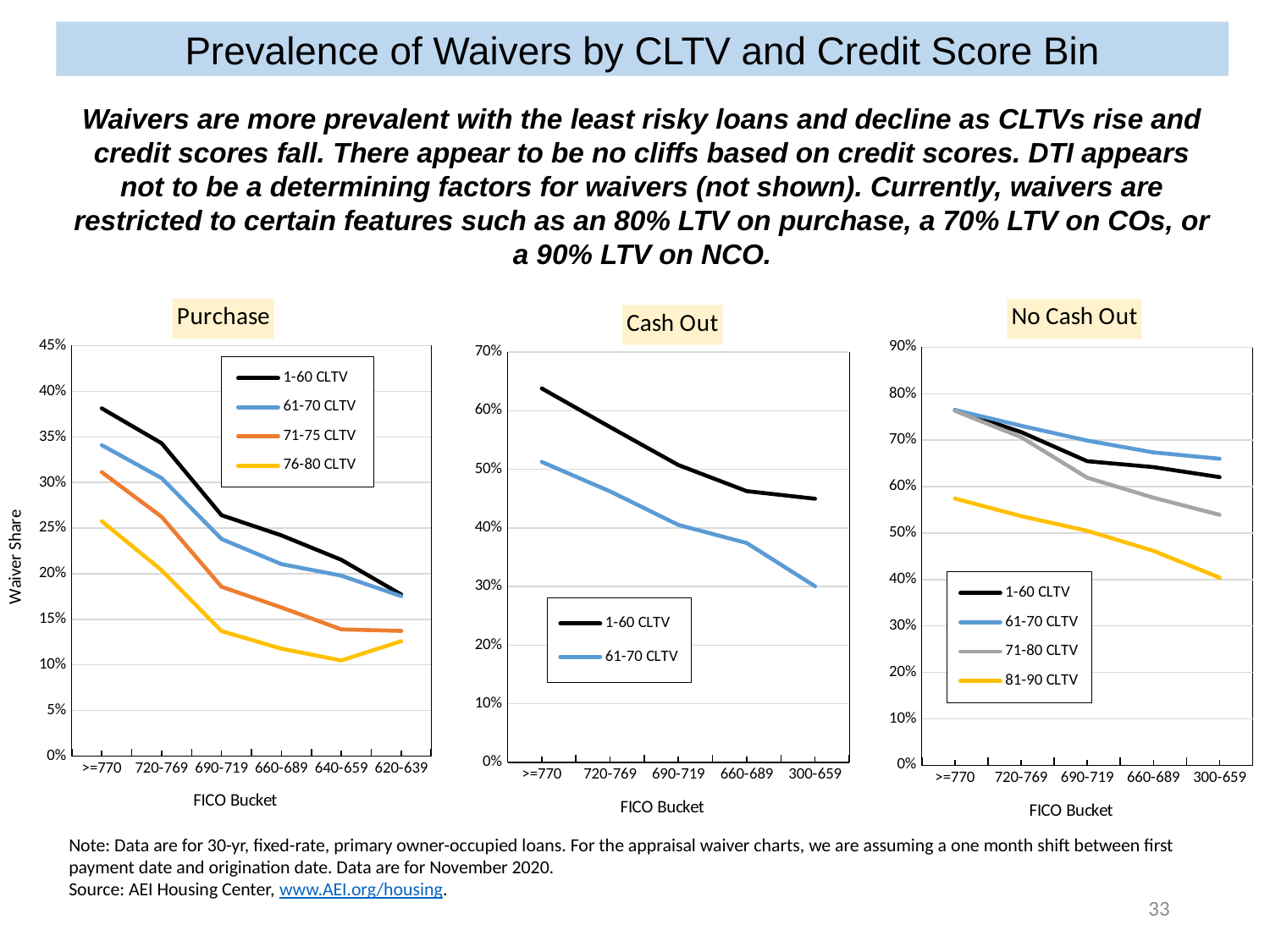
How many FICO buckets are shown on the x axis of the No Cash Out chart? 5 What kind of chart is the Purchase chart? line chart How many FICO buckets are shown on the x axis of the Purchase chart? 6 In the Cash Out chart, does the 1-60 CLTV line rise or fall as FICO buckets move from >=770 to 300-659? fall In the Purchase chart, which series is larger at >=770: 1-60 CLTV or 76-80 CLTV? 1-60 CLTV In the Purchase chart, is the value for 1-60 CLTV at >=770 greater or less than 35%? greater In the Cash Out chart, is the value for 1-60 CLTV at >=770 greater or less than 60%? greater What is the label on the y axis of the Purchase chart? Waiver Share How many series does the legend of the Cash Out chart list? 2 In the No Cash Out chart, is the value for 81-90 CLTV at 300-659 greater or less than 50%? less How many series does the legend of the Purchase chart list? 4 In the Purchase chart, which series has the lowest value at 690-719? 76-80 CLTV